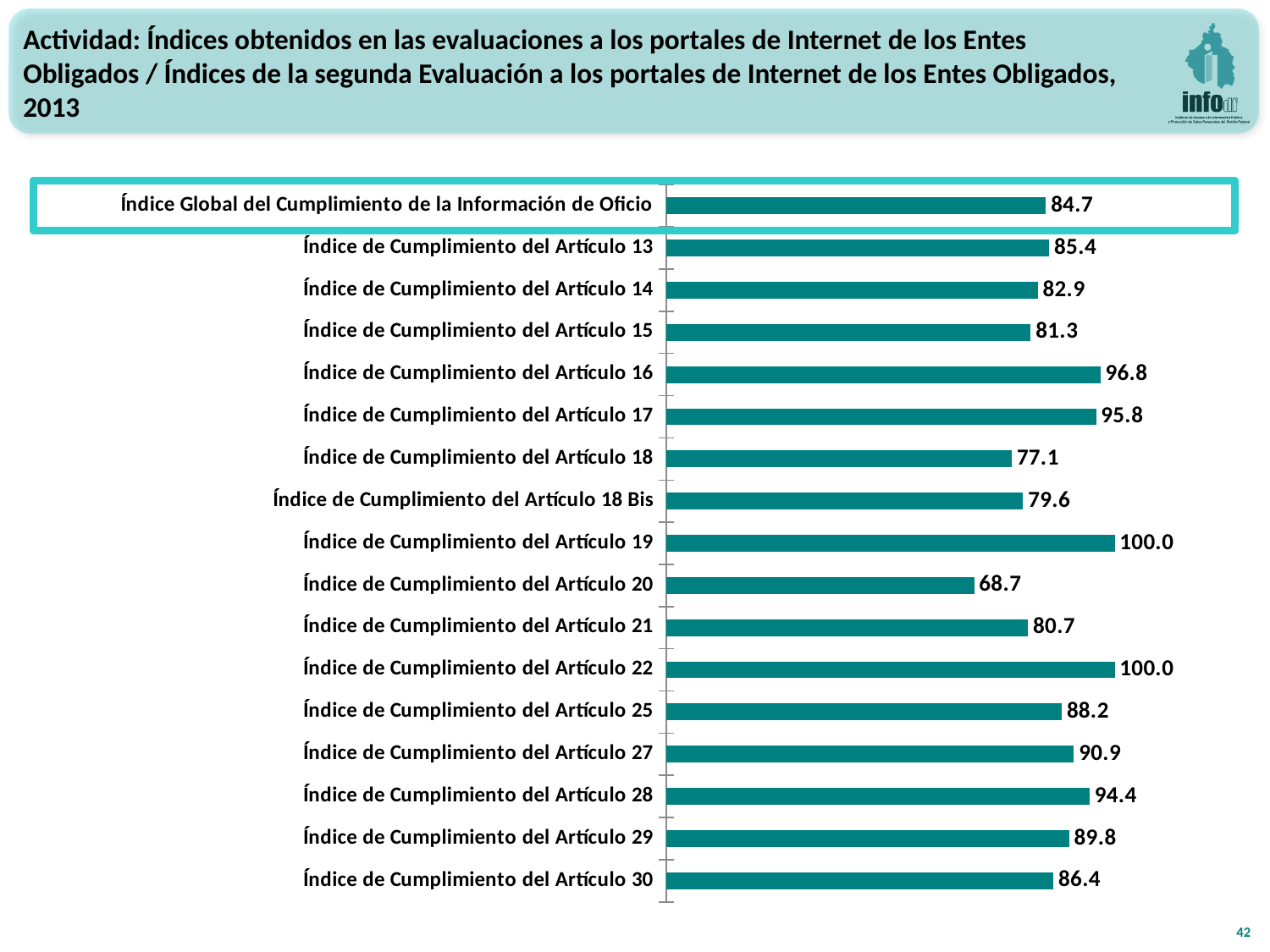
What is the difference between the values for Artículo 17 and Artículo 18? 18.7 How many categories are shown in the chart? 17 What kind of chart is shown on the slide? Bar chart What is the difference between the values for Artículo 25 and Artículo 30? 1.8 What is the value for Índice de Cumplimiento del Artículo 28? 94.4 What is the value for Índice Global del Cumplimiento de la Información de Oficio? 84.7 What is the value for Índice de Cumplimiento del Artículo 16? 96.8 Which two categories share the highest value of 100.0? Índice de Cumplimiento del Artículo 19 and Índice de Cumplimiento del Artículo 22 What is the value for Índice de Cumplimiento del Artículo 18 Bis? 79.6 What colour are the bars in the chart? Teal Which category has the lowest value? Índice de Cumplimiento del Artículo 20 Which is larger, the value for Artículo 27 or the value for Artículo 29? Artículo 27